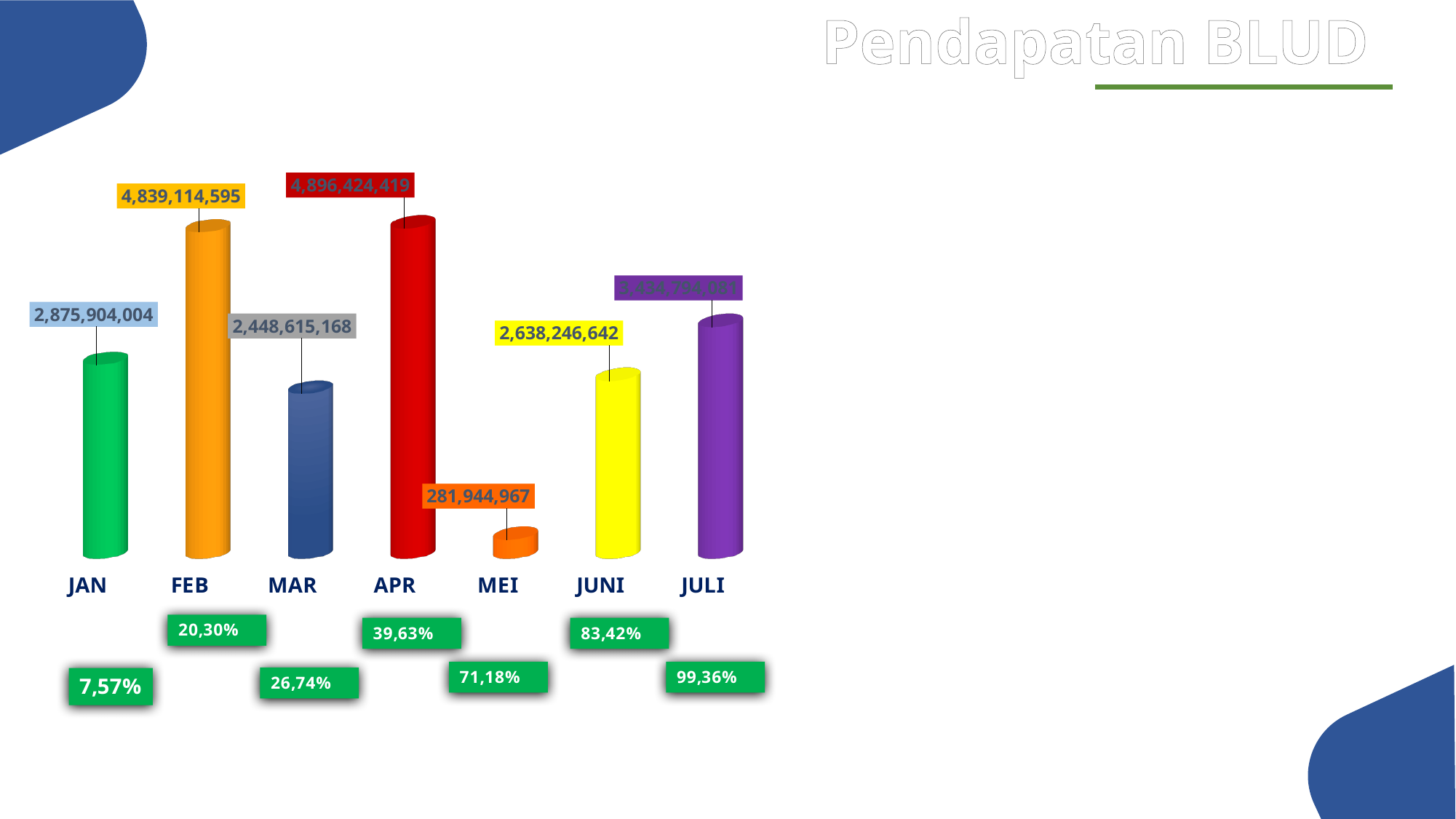
What is the value for FEB? 4,839,114,595 What is the value for JUNI? 2,638,246,642 How many months are shown on the chart? 7 What is the value for JAN? 2,875,904,004 What is the value for MEI? 281,944,967 Which month has the lowest value? MEI Which is larger, the value for JAN or the value for MAR? JAN What kind of chart is shown on the slide? Bar chart Which month has the highest value? APR What is the difference between the values for JAN and JUNI? 237,657,362 What is the value for MAR? 2,448,615,168 What is the difference between the values for FEB and MAR? 2,390,499,427